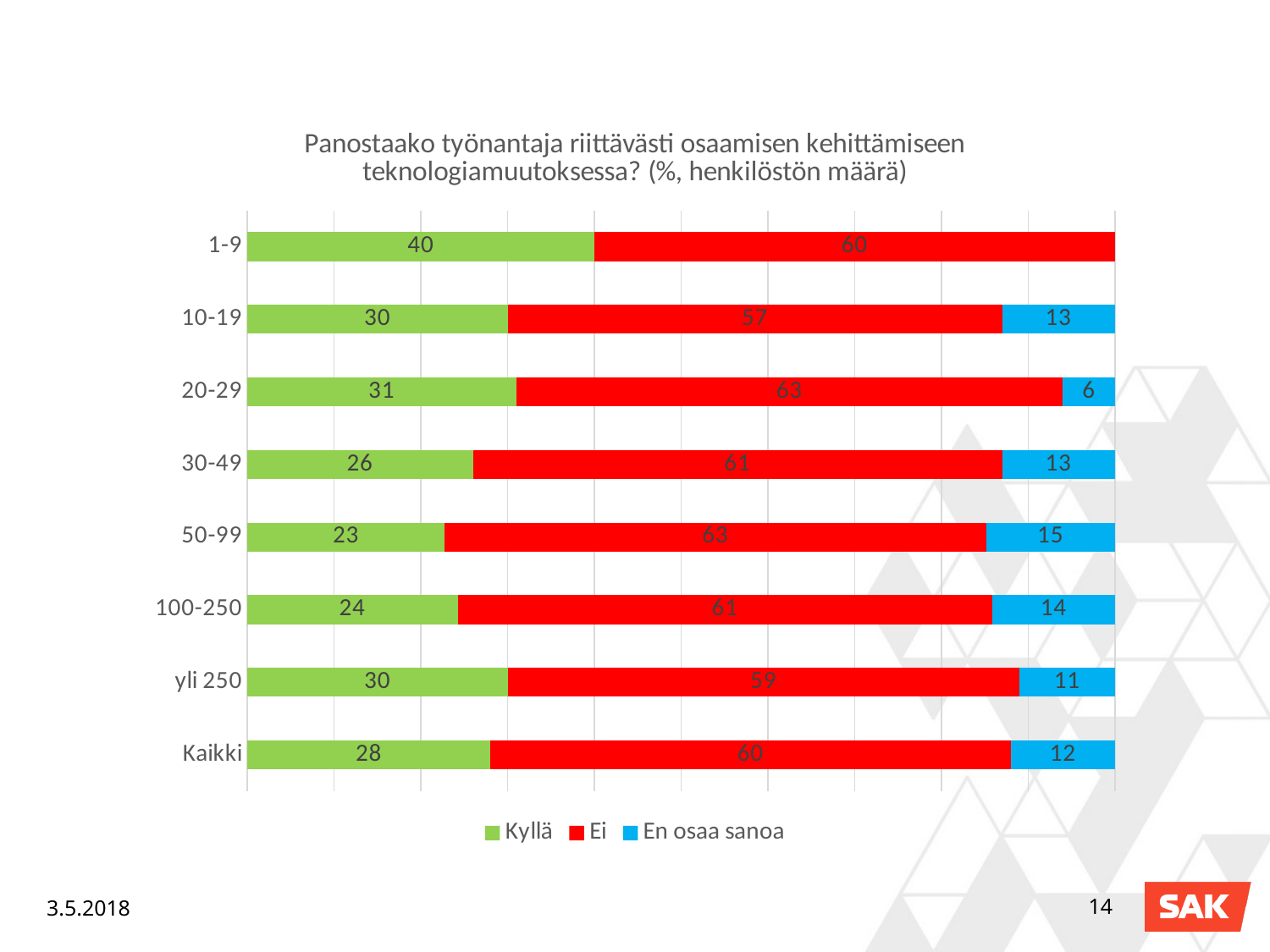
How many series does the legend list? 3 What is the En osaa sanoa value for the 50-99 category? 15 What is the Kyllä value for Kaikki? 28 What is the Ei value for the 20-29 category? 63 Which category has the lowest Kyllä value? 50-99 Which category has the highest Kyllä value? 1-9 What kind of chart is shown on the slide? Stacked bar chart What is the difference between the Kyllä values for 1-9 and 30-49? 14 Which is larger, the Ei value for 10-19 or the Ei value for yli 250? yli 250 What is the Kyllä value for the 1-9 category? 40 Which category has the lowest En osaa sanoa value among those with a printed label? 20-29 How many categories are shown on the y axis? 8